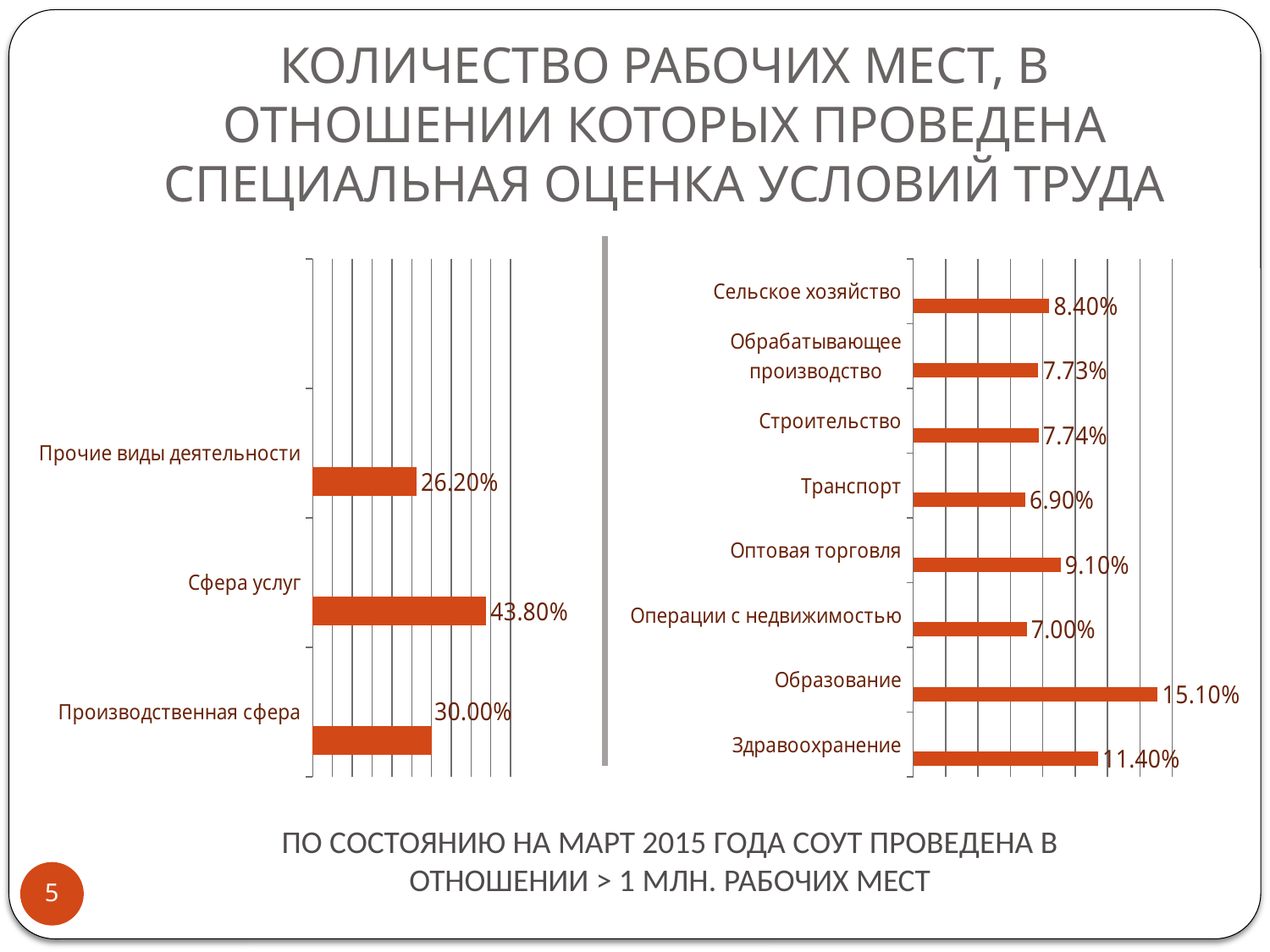
In the right chart, which category has the highest value? Образование In the left chart, how many categories are shown? 3 In the right chart, which category has the lowest value? Транспорт In the left chart, what is the value for Сфера услуг? 43.80% In the right chart, what is the value for Транспорт? 6.90% In the right chart, which is larger: Оптовая торговля or Операции с недвижимостью? Оптовая торговля In the left chart, what is the difference between Сфера услуг and Производственная сфера? 13.80% In the left chart, what is the value for Производственная сфера? 30.00% What type of chart is the right chart? Bar chart In the right chart, what is the difference between Образование and Здравоохранение? 3.70% In the right chart, what is the value for Образование? 15.10% In the left chart, which category has the lowest value? Прочие виды деятельности